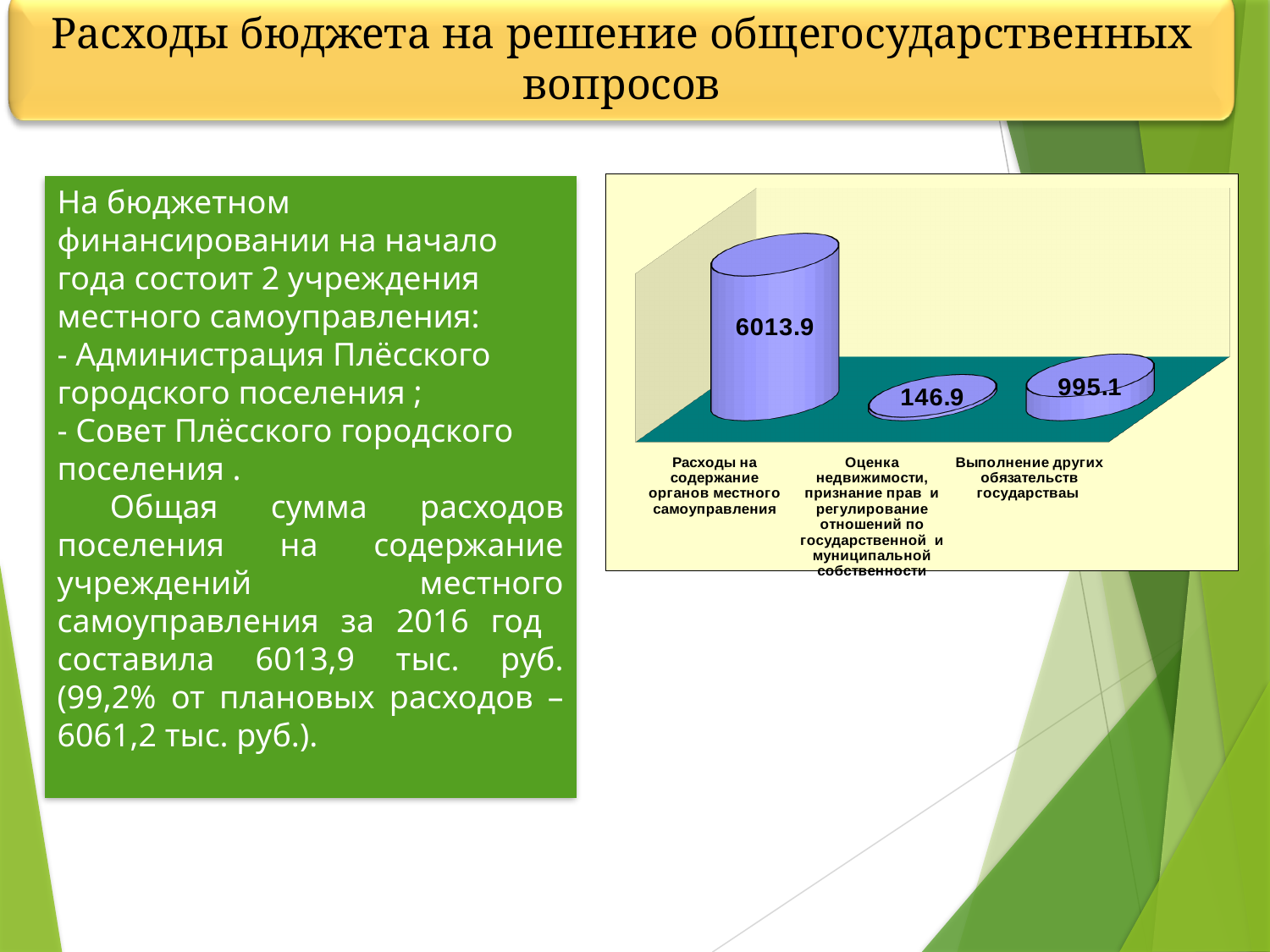
What is the title of the slide containing the chart? Расходы бюджета на решение общегосударственных вопросов How many categories are shown in the chart? 3 What is the value for "Оценка недвижимости, признание прав и регулирование отношений по государственной и муниципальной собственности"? 146.9 What kind of chart is shown on the slide? Bar chart Which category has the highest value? Расходы на содержание органов местного самоуправления What is the difference between the values for "Расходы на содержание органов местного самоуправления" and "Выполнение других обязательств государстваы"? 5018.8 What is the value for "Выполнение других обязательств государстваы"? 995.1 What is the value for "Расходы на содержание органов местного самоуправления"? 6013.9 Does the value fall or rise from the first category to the second category? Fall What is the difference between the values for "Выполнение других обязательств государстваы" and "Оценка недвижимости, признание прав и регулирование отношений по государственной и муниципальной собственности"? 848.2 Which category has the lowest value? Оценка недвижимости, признание прав и регулирование отношений по государственной и муниципальной собственности Which is larger: the value for "Выполнение других обязательств государстваы" or the value for "Оценка недвижимости, признание прав и регулирование отношений по государственной и муниципальной собственности"? Выполнение других обязательств государстваы